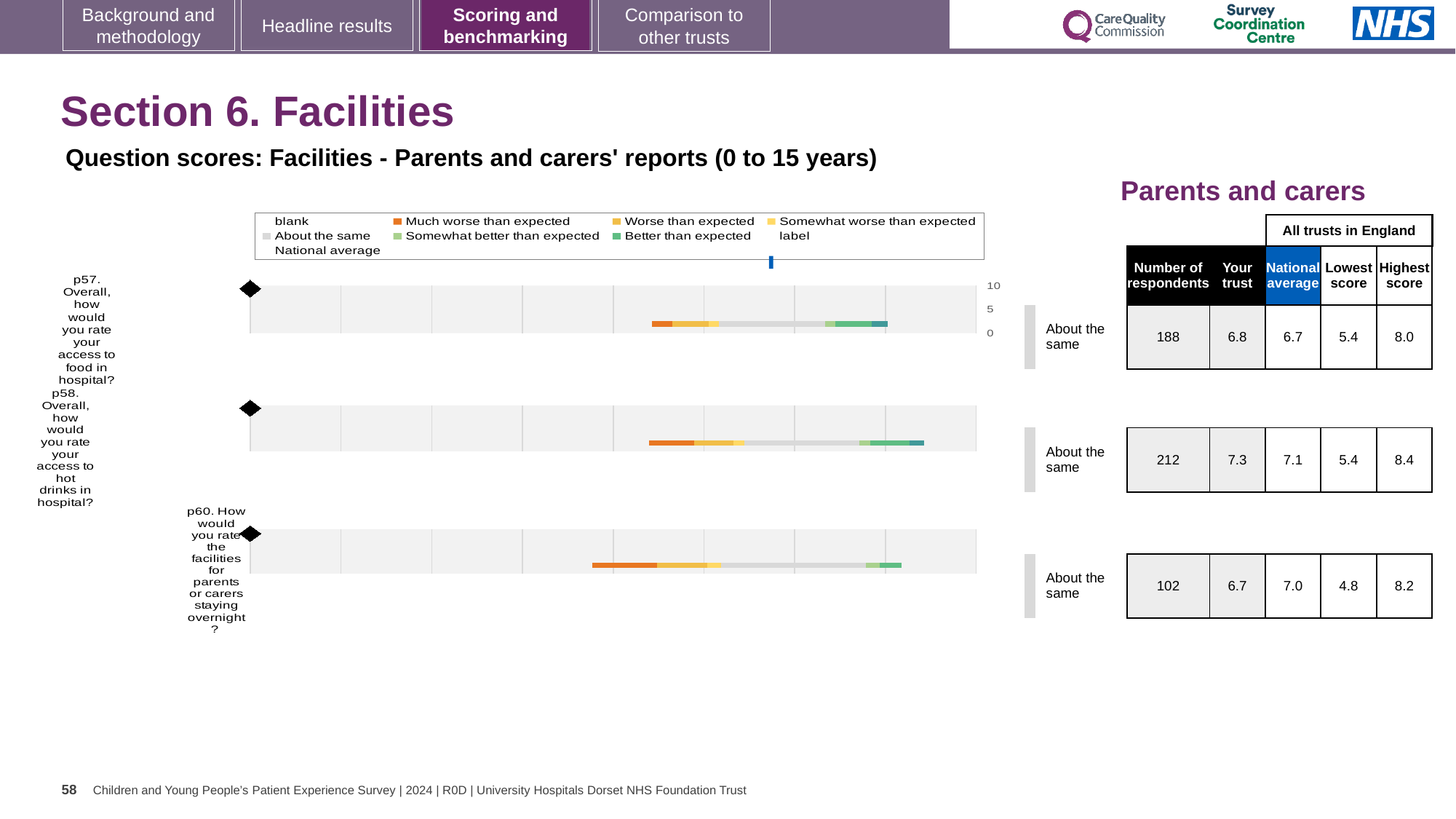
For p57, which is larger: the 'Your trust' score or the national average? Your trust What is the national average score for p58 (access to hot drinks in hospital)? 7.1 What benchmark category is shown for p60? About the same What is the difference between the 'Your trust' score and the national average for p58? 0.2 What is the difference between the highest and lowest scores in England for p57? 2.6 Which question has the highest 'Your trust' score? p58 What kind of chart is used to show the question scores for p57, p58 and p60? bar chart How many survey questions are plotted on the slide? 3 Which question has the lowest 'Your trust' score? p60 How many respondents answered p60 (facilities for parents or carers staying overnight)? 102 What is the 'Your trust' score for p57 (access to food in hospital)? 6.8 What is the highest score among all trusts in England for p58? 8.4